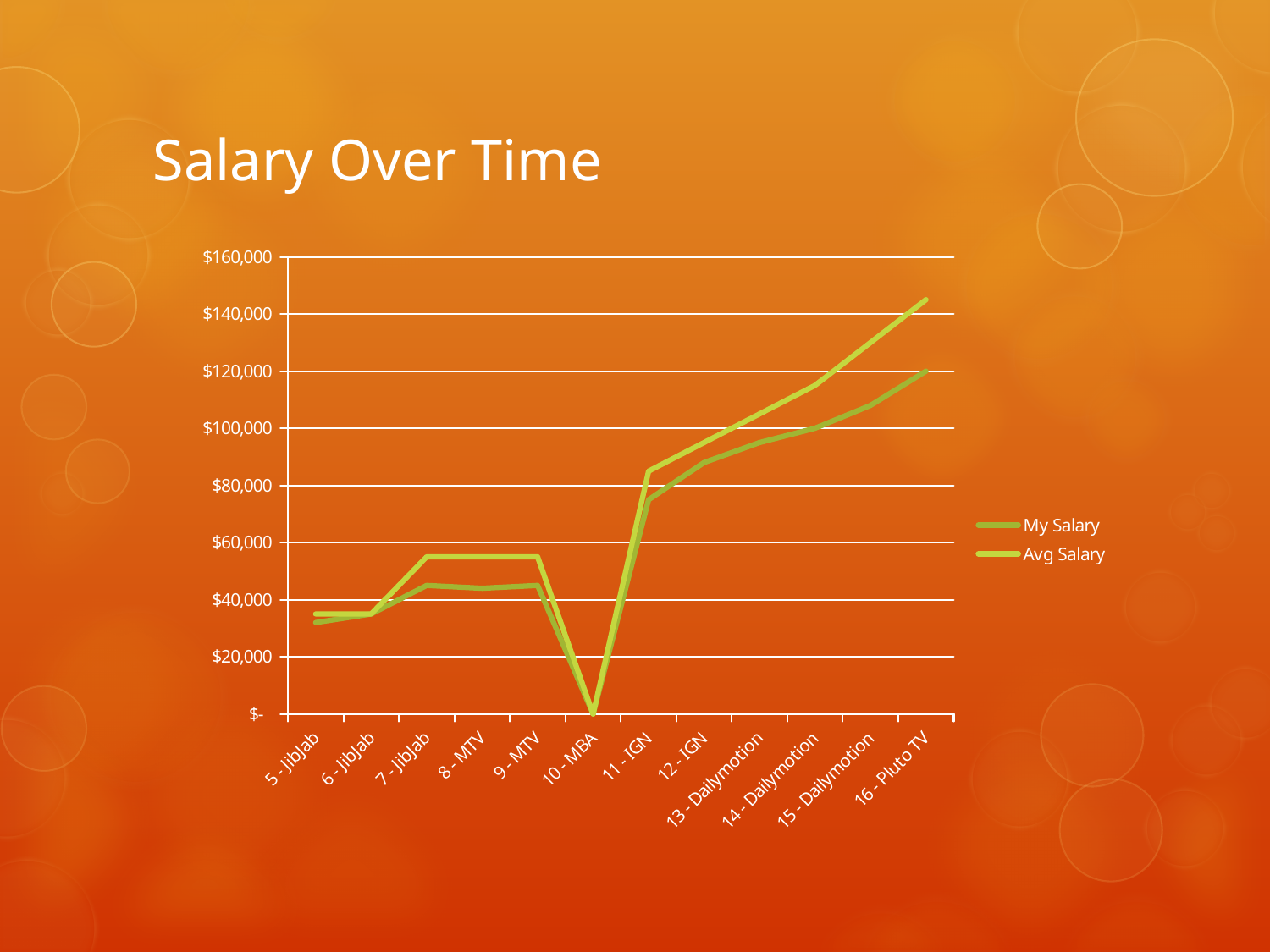
Is the value of Avg Salary at 13 - Dailymotion greater or less than $80,000? greater What is the value of My Salary at 10 - MBA? $- How many categories are shown on the x axis? 12 What kind of chart is shown on the slide? line chart Is the value of My Salary at 7 - JibJab greater or less than $60,000? less At 16 - Pluto TV, which series has the larger value, My Salary or Avg Salary? Avg Salary How many series does the legend list? 2 Is the value of Avg Salary at 5 - JibJab greater or less than $40,000? less What is the title of the chart? Salary Over Time Which category has the highest My Salary value? 16 - Pluto TV Which category has the lowest My Salary value? 10 - MBA